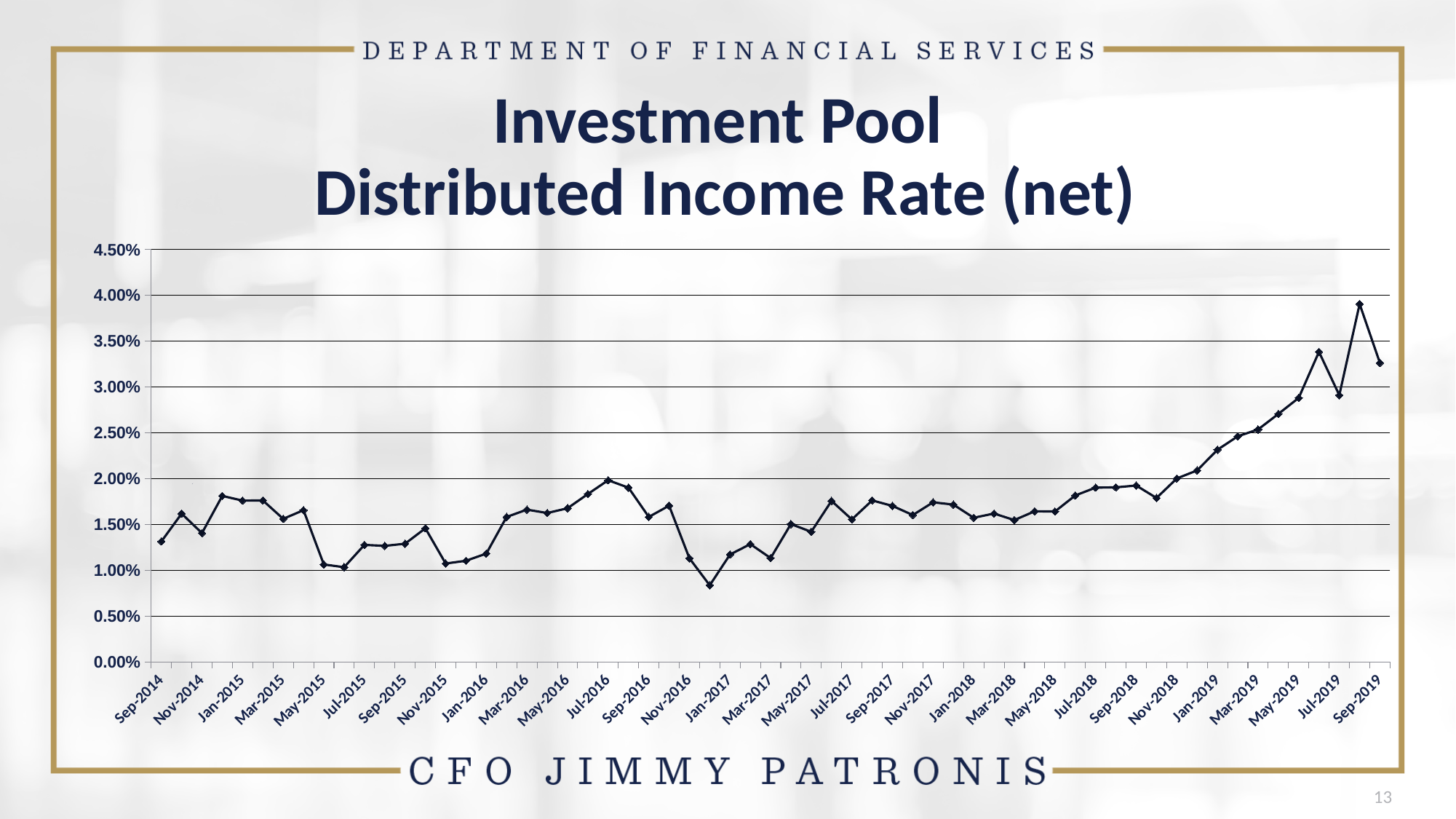
Which is larger, the value for Jan-2015 or the value for Jan-2017? Jan-2015 Is the value for Jul-2015 greater or less than 1.50%? less Which is larger, the value for Sep-2014 or the value for Sep-2019? Sep-2019 Is the value for Jan-2017 greater or less than 1.50%? less What is the title of the chart? Investment Pool Distributed Income Rate (net) What kind of chart is shown on the slide? Line chart Is the value for Sep-2014 greater or less than 1.50%? less What is the highest value shown on the vertical axis? 4.50% Overall, does the distributed income rate rise or fall from Sep-2014 to Sep-2019? Rise